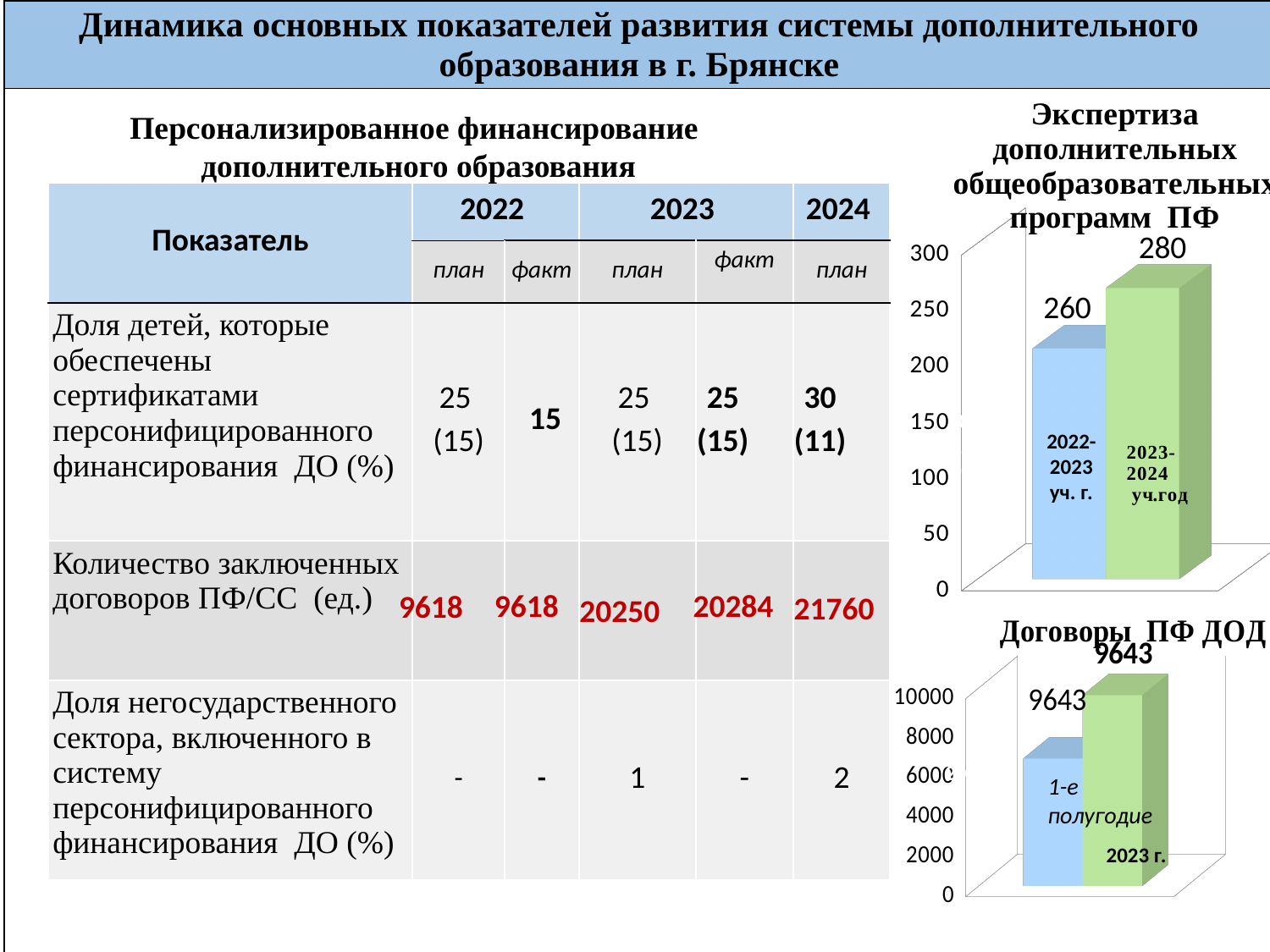
In the chart titled 'Экспертиза дополнительных общеобразовательных программ ПФ', what is the value for 2023-2024 уч.год? 280 In the chart titled 'Экспертиза дополнительных общеобразовательных программ ПФ', what is the difference between the 2023-2024 and 2022-2023 values? 20 In the chart titled 'Экспертиза дополнительных общеобразовательных программ ПФ', what is the value for 2022-2023 уч. г.? 260 In the chart titled 'Экспертиза дополнительных общеобразовательных программ ПФ', which bar is the lowest? 2022-2023 уч. г. What kind of chart is the one titled 'Договоры ПФ ДОД'? bar chart In the chart titled 'Договоры ПФ ДОД', how many bars are plotted? 2 In the chart titled 'Договоры ПФ ДОД', what is the highest value shown on the vertical axis? 10000 In the chart titled 'Экспертиза дополнительных общеобразовательных программ ПФ', do the values rise or fall from 2022-2023 to 2023-2024? rise In the chart titled 'Экспертиза дополнительных общеобразовательных программ ПФ', how many bars are plotted? 2 In the chart titled 'Экспертиза дополнительных общеобразовательных программ ПФ', which bar is the highest? 2023-2024 уч.год